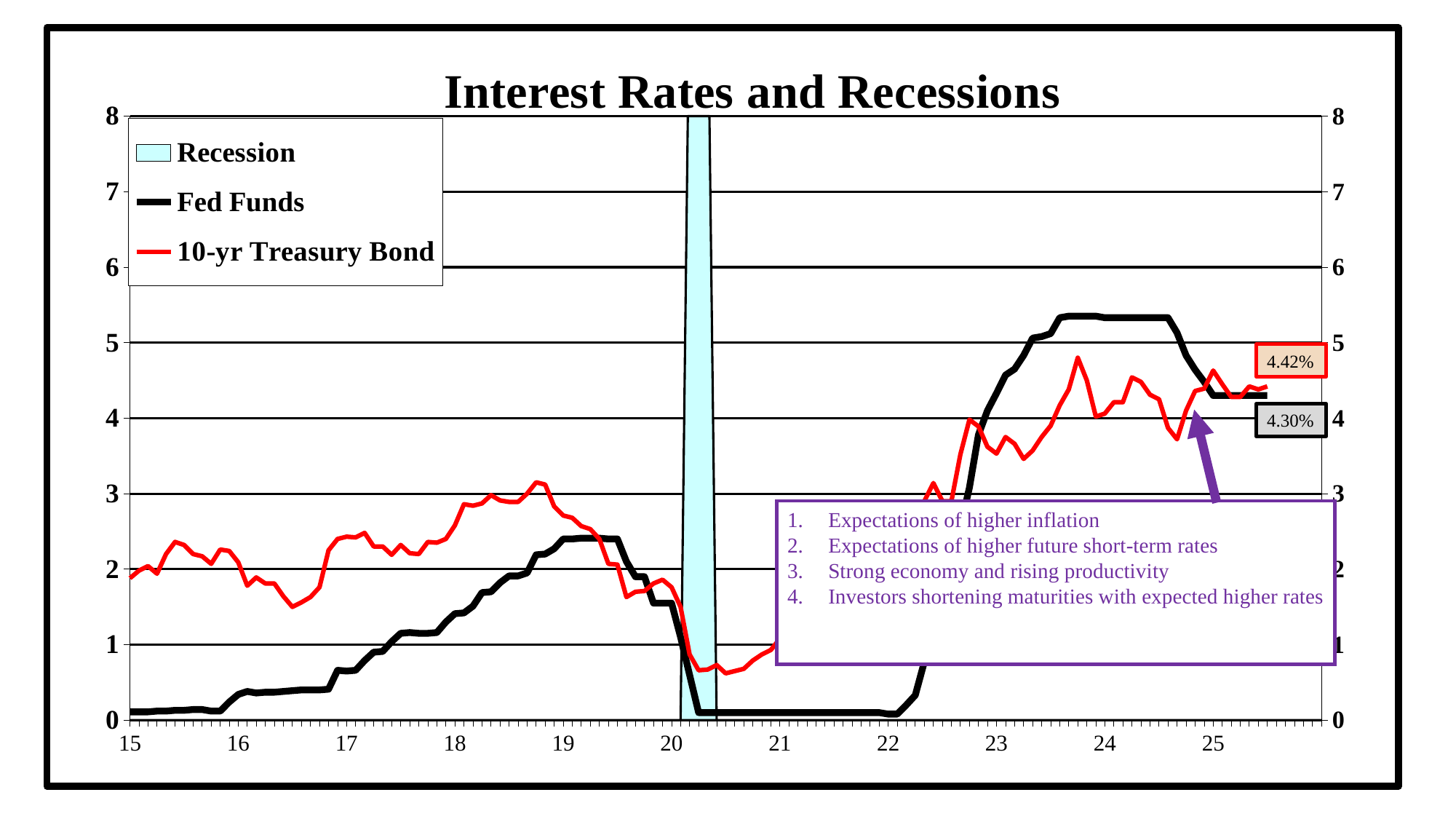
What is the title of the chart? Interest Rates and Recessions Is the 10-yr Treasury Bond value at the start of 2015 greater or less than 3? less What colour is the 10-yr Treasury Bond line? red Is the Fed Funds value during 2021 greater or less than 1? less Does the Fed Funds series rise or fall between 2015 and 2019? rises How many entries does the chart's legend list? 3 What is the latest labelled value of the Fed Funds series? 4.30% At the end of the chart, which is higher: the 10-yr Treasury Bond or Fed Funds? 10-yr Treasury Bond What is the difference between the labelled 10-yr Treasury Bond value (4.42%) and the labelled Fed Funds value (4.30%)? 0.12% What is the latest labelled value of the 10-yr Treasury Bond series? 4.42% What kind of chart is shown on the slide? line chart